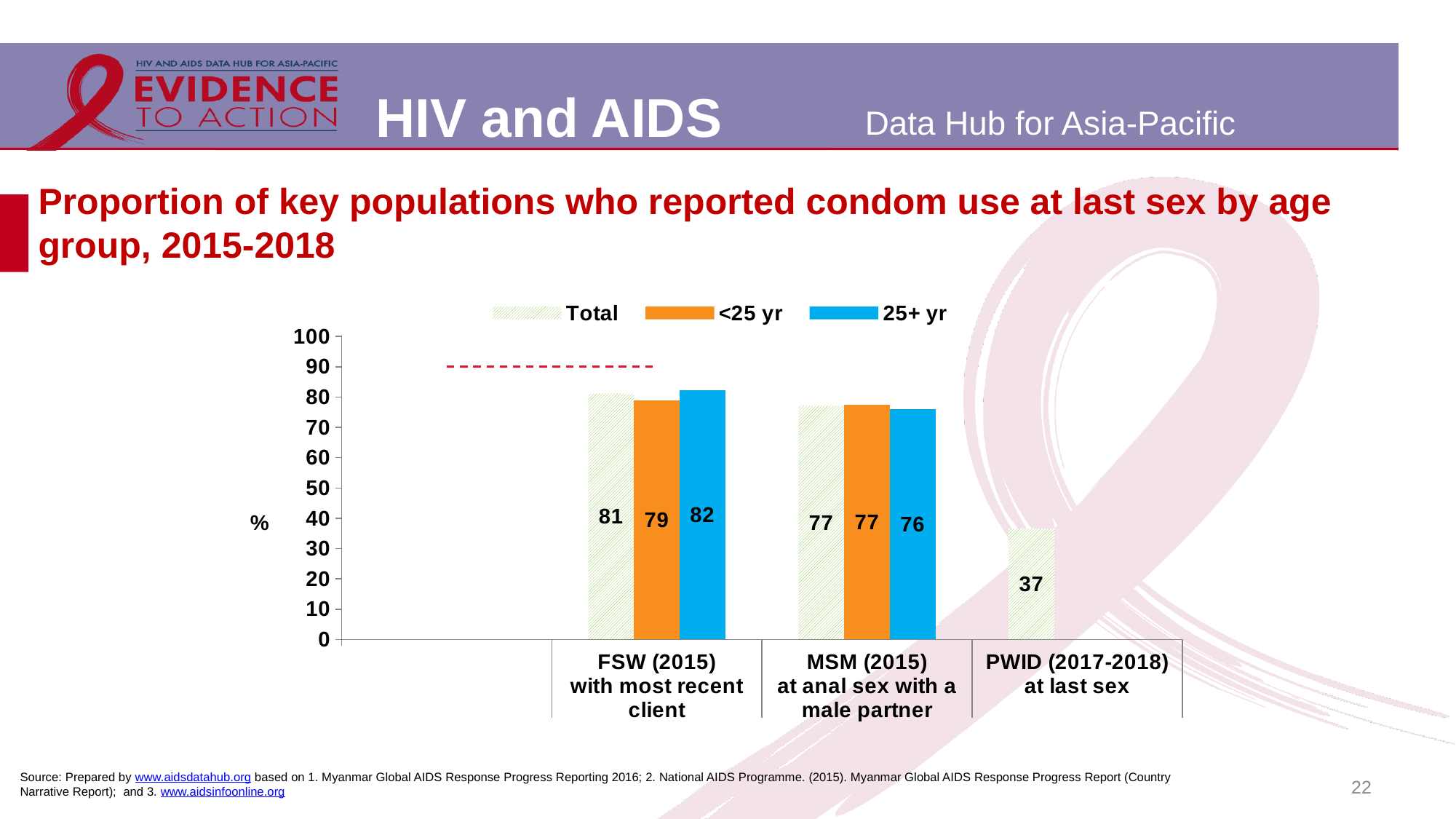
How many series does the legend list? 3 What is the Total value for PWID (2017-2018) at last sex? 37 How many key population categories are shown on the x axis? 3 What kind of chart is shown on the slide? bar chart What is the <25 yr value for MSM (2015) at anal sex with a male partner? 77 What is the difference between the Total values for FSW (2015) and PWID (2017-2018)? 44 What is the 25+ yr value for FSW (2015) with most recent client? 82 What is the Total value for FSW (2015) with most recent client? 81 Which is larger for FSW (2015): the <25 yr value or the 25+ yr value? 25+ yr Which key population has the highest 25+ yr value? FSW (2015) with most recent client Which key population has the lowest Total value? PWID (2017-2018) at last sex Is the Total value for PWID (2017-2018) greater or less than 50? less